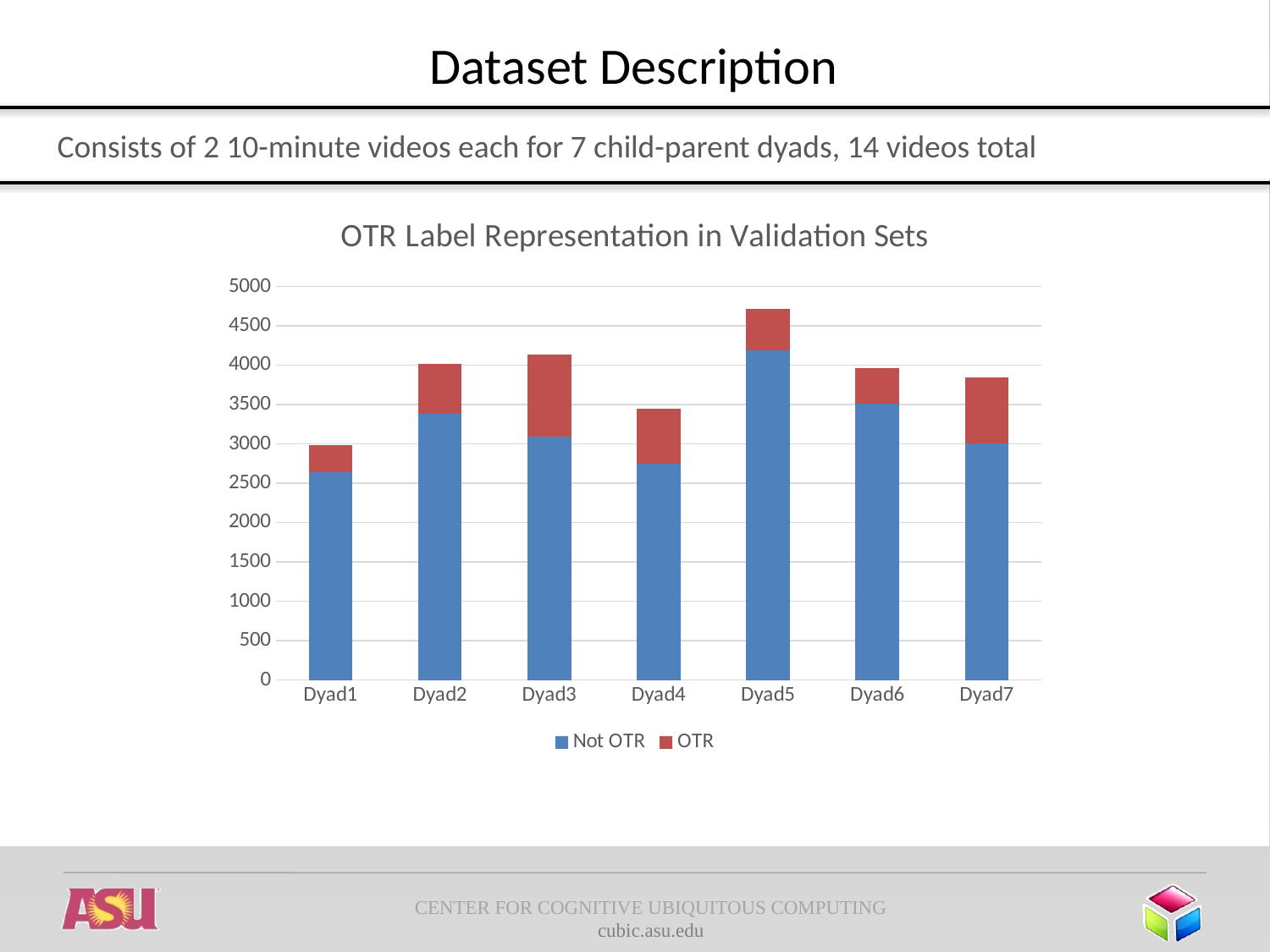
How many series does the legend list? 2 Which has the larger total bar, Dyad2 or Dyad4? Dyad2 Which dyad has the largest OTR segment? Dyad3 How many dyads (categories) are shown on the x axis? 7 Is the Not OTR value for Dyad1 greater or less than 2500? greater Is the total bar for Dyad5 greater or less than 4500? greater What kind of chart is shown on the slide? Stacked bar chart Is the Not OTR value for Dyad5 greater or less than 4000? greater What is the title of the chart? OTR Label Representation in Validation Sets Which colour represents the OTR series in the legend? Red Which dyad has the tallest total bar? Dyad5 Which dyad has the shortest total bar? Dyad1